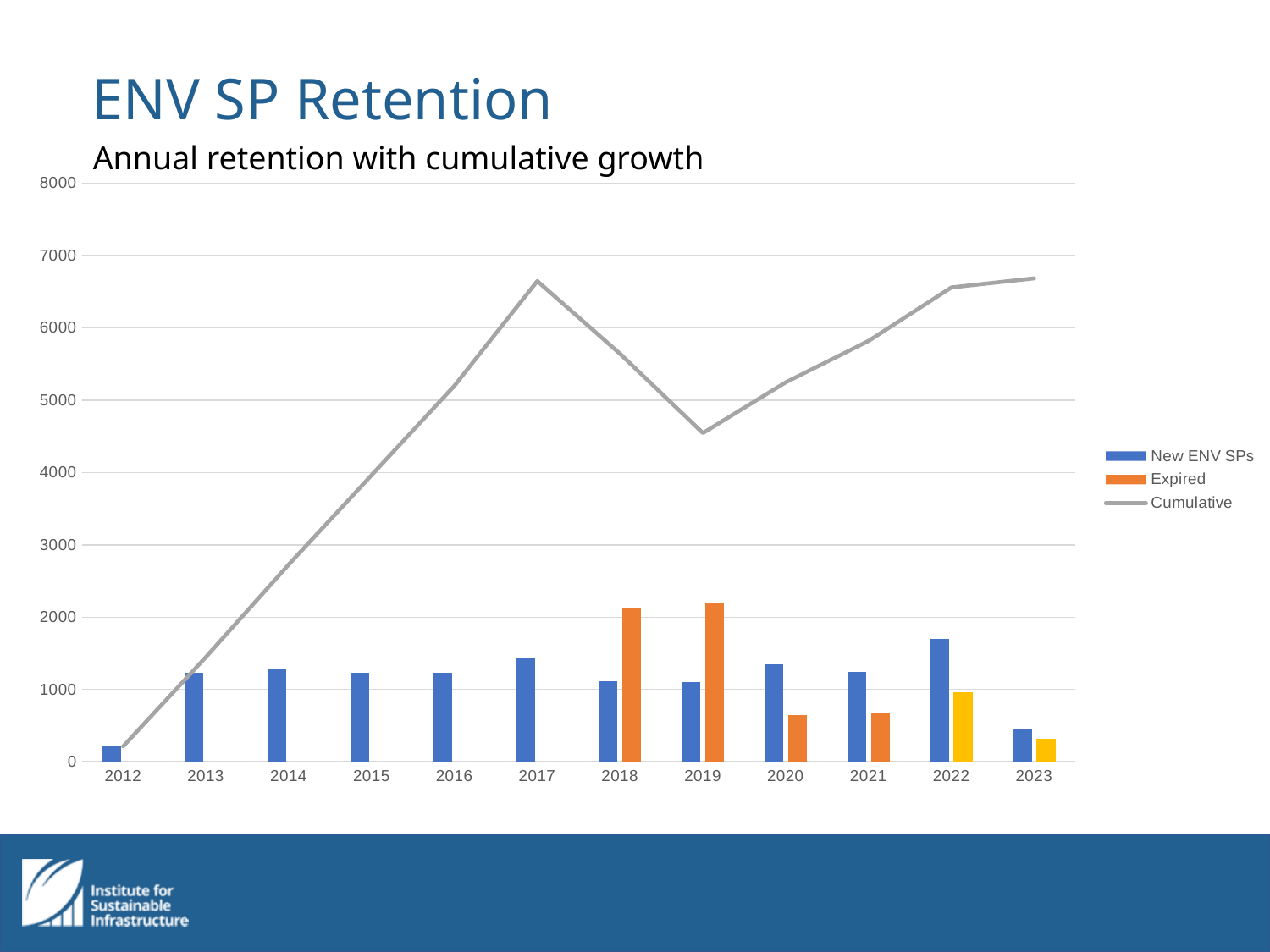
Which year has the lowest New ENV SPs bar? 2012 Is the Cumulative value for 2017 greater or less than 6000? greater Is the New ENV SPs value for 2022 greater or less than 1000? greater How many series does the chart's legend list? 3 How many years are shown on the x axis of the chart? 12 What kind of chart is shown on the slide? A combined bar and line chart In 2018, which is larger: New ENV SPs or Expired? Expired What is the subtitle of the chart? Annual retention with cumulative growth Is the Cumulative value for 2019 greater or less than 5000? less Which year has the highest New ENV SPs bar? 2022 Does the Cumulative line rise or fall from 2012 to 2017? rise